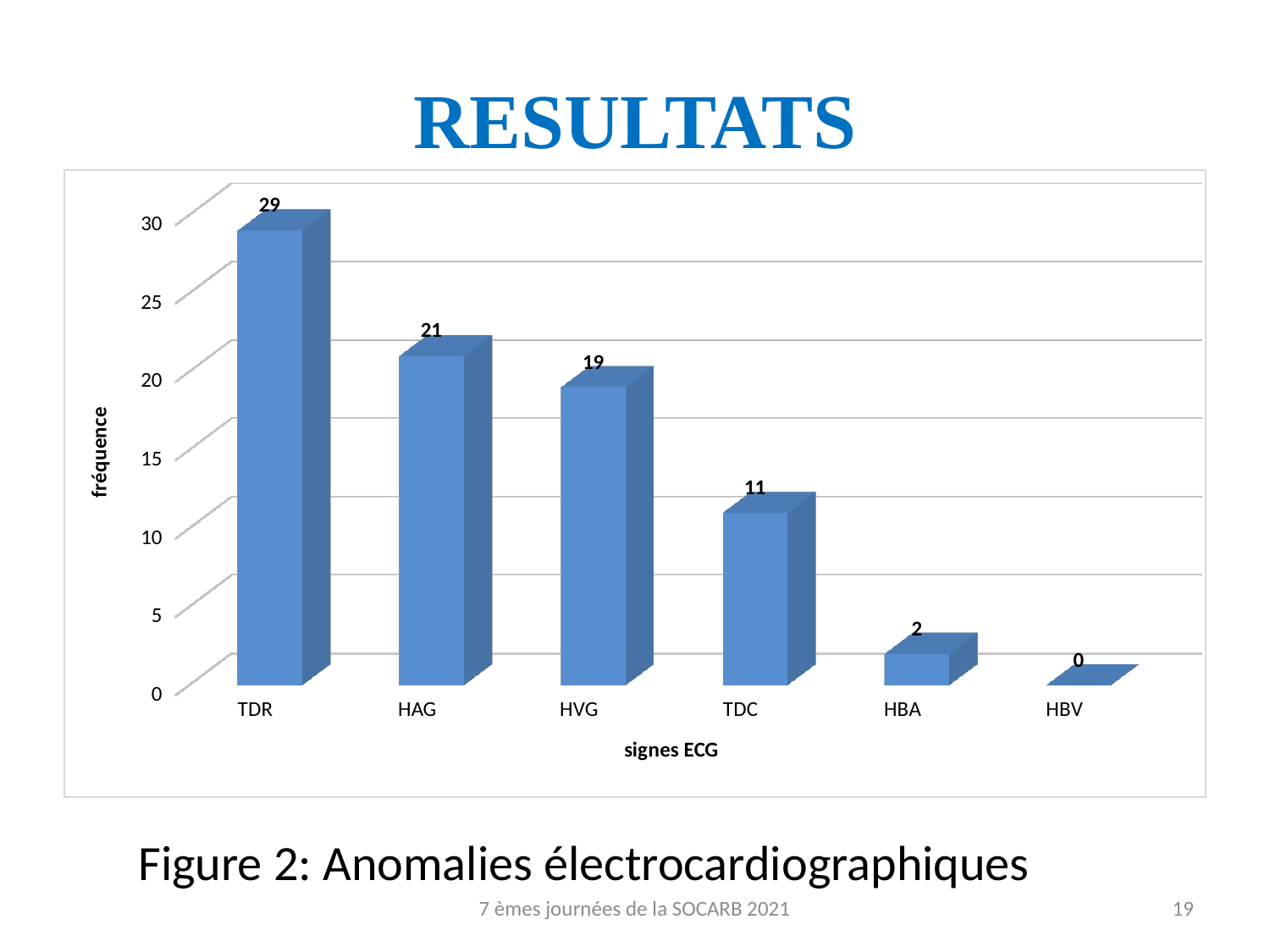
What is the difference between the values for HVG and TDC? 8 What kind of chart is this? bar chart What is the value for TDR? 29 Which is larger, the value for HVG or the value for HBA? HVG Which category has the highest value? TDR What is the value for HAG? 21 What is the label of the x axis? signes ECG What is the value for HBV? 0 How many categories are shown on the x axis? 6 Which category has the lowest value? HBV What is the value for TDC? 11 What is the difference between the values for TDR and HAG? 8